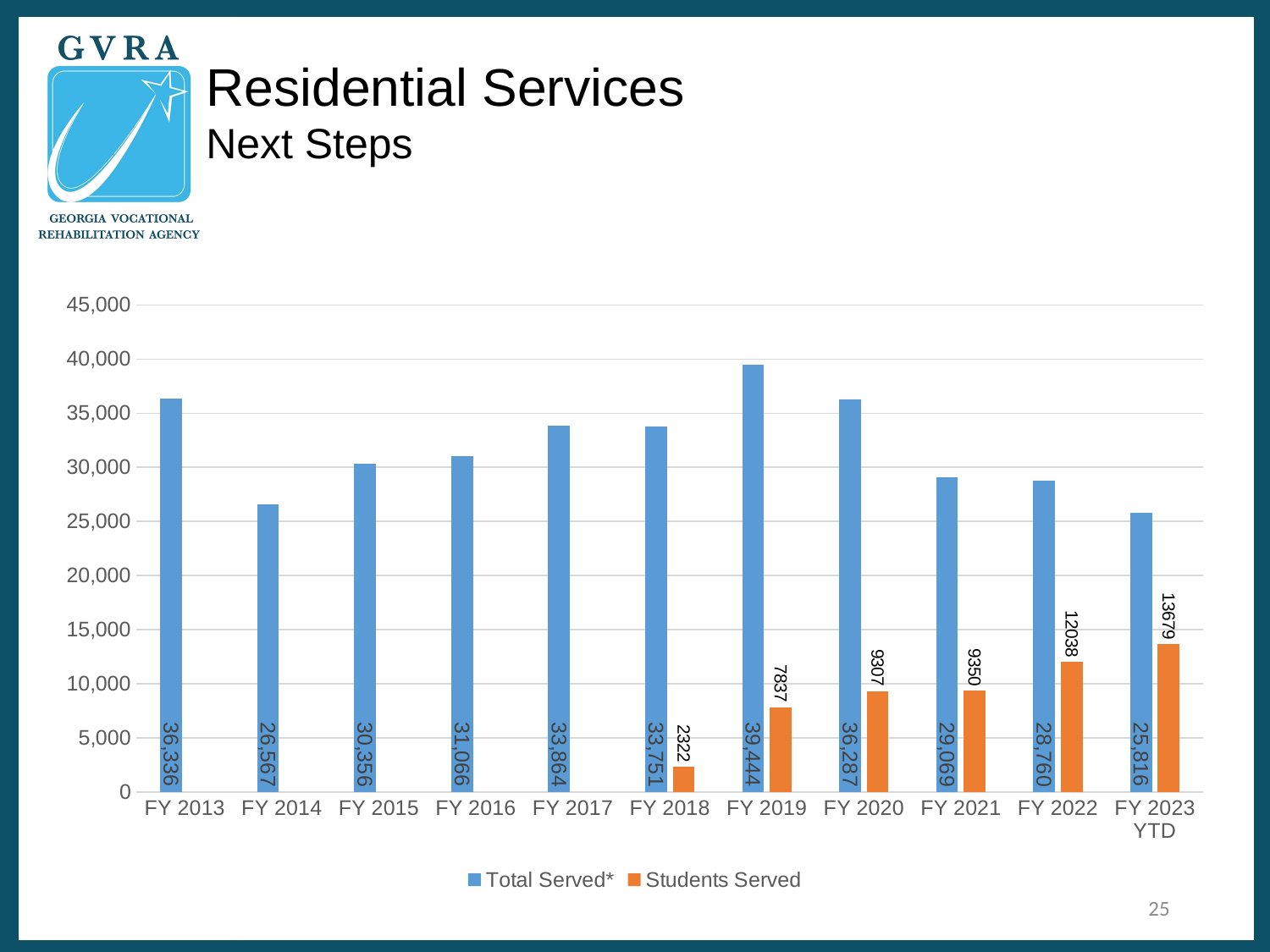
What kind of chart is shown on the slide? Bar chart Which fiscal year has the lowest Students Served value? FY 2018 What is the Students Served value for FY 2022? 12038 Which is larger, Students Served in FY 2022 or in FY 2023 YTD? FY 2023 YTD How many series does the legend list? 2 Which fiscal year has the lowest Total Served* value? FY 2023 YTD What is the difference between Total Served* in FY 2019 and FY 2020? 3,157 What is the Total Served* value for FY 2014? 26,567 What is the Total Served* value for FY 2019? 39,444 Which fiscal year has the highest Total Served* value? FY 2019 Is the Total Served* value for FY 2017 greater or less than 30,000? greater How many fiscal years are shown on the x axis? 11